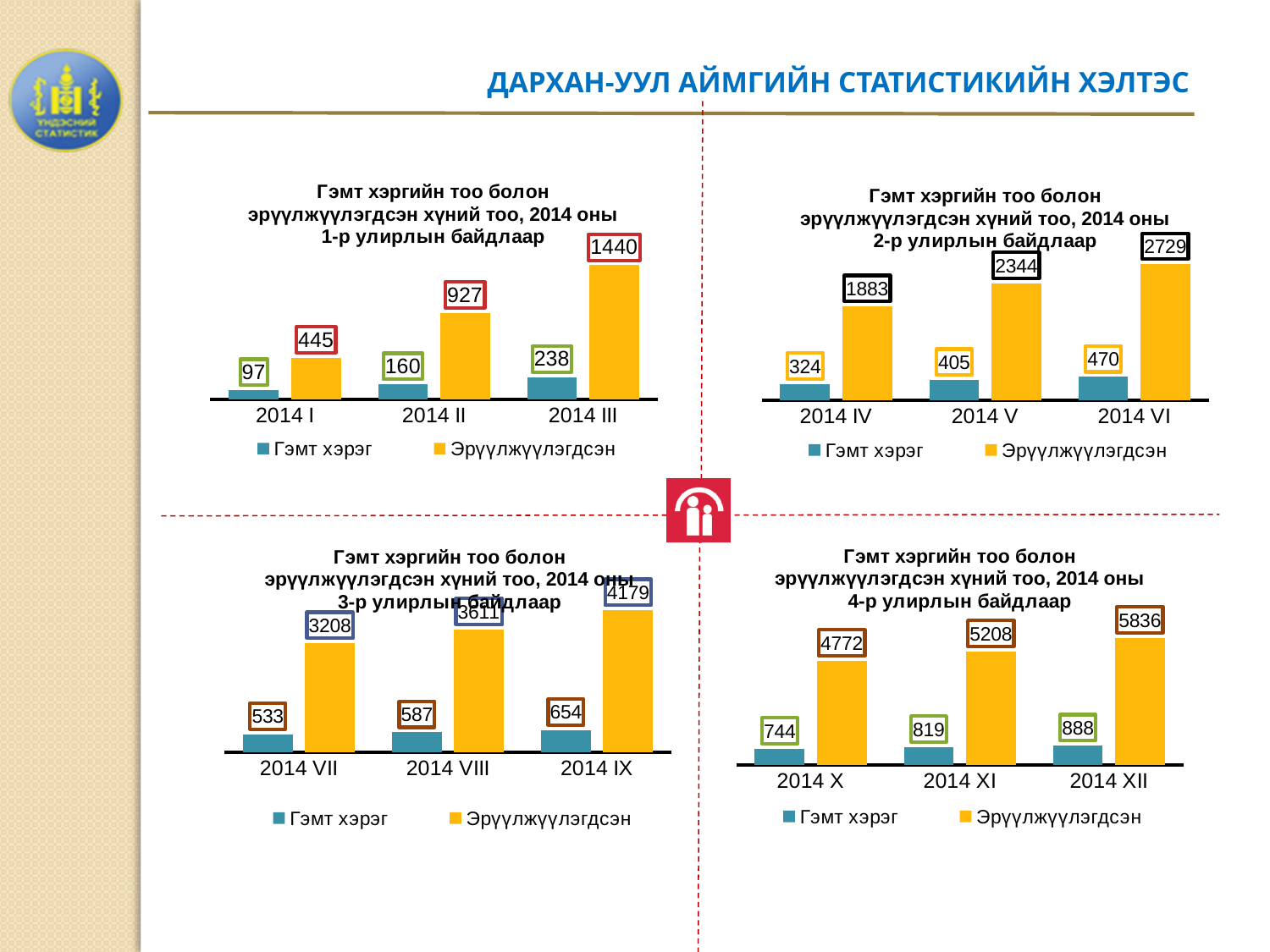
What type of chart is the bottom-left chart (3-р улирлын байдлаар)? bar chart In the bottom-left chart (3-р улирлын байдлаар), what is the difference between the Эрүүлжүүлэгдсэн values for 2014 IX and 2014 VII? 971 In the top-left chart (1-р улирлын байдлаар), what is the value of Гэмт хэрэг for 2014 I? 97 In the top-right chart (2-р улирлын байдлаар), which month has the highest Гэмт хэрэг value? 2014 VI In the top-left chart (1-р улирлын байдлаар), does the Эрүүлжүүлэгдсэн value rise or fall from 2014 I to 2014 III? rise In the top-left chart (1-р улирлын байдлаар), what is the value of Эрүүлжүүлэгдсэн for 2014 III? 1440 In the bottom-right chart (4-р улирлын байдлаар), which month has the lowest Гэмт хэрэг value? 2014 X In the bottom-right chart (4-р улирлын байдлаар), what is the value of Эрүүлжүүлэгдсэн for 2014 XII? 5836 In the bottom-right chart (4-р улирлын байдлаар), what is the difference between the Гэмт хэрэг values for 2014 XII and 2014 XI? 69 In the top-right chart (2-р улирлын байдлаар), what is the value of Эрүүлжүүлэгдсэн for 2014 V? 2344 In the bottom-left chart (3-р улирлын байдлаар), what is the value of Гэмт хэрэг for 2014 VIII? 587 How many series does the legend of the top-right chart (2-р улирлын байдлаар) list? 2